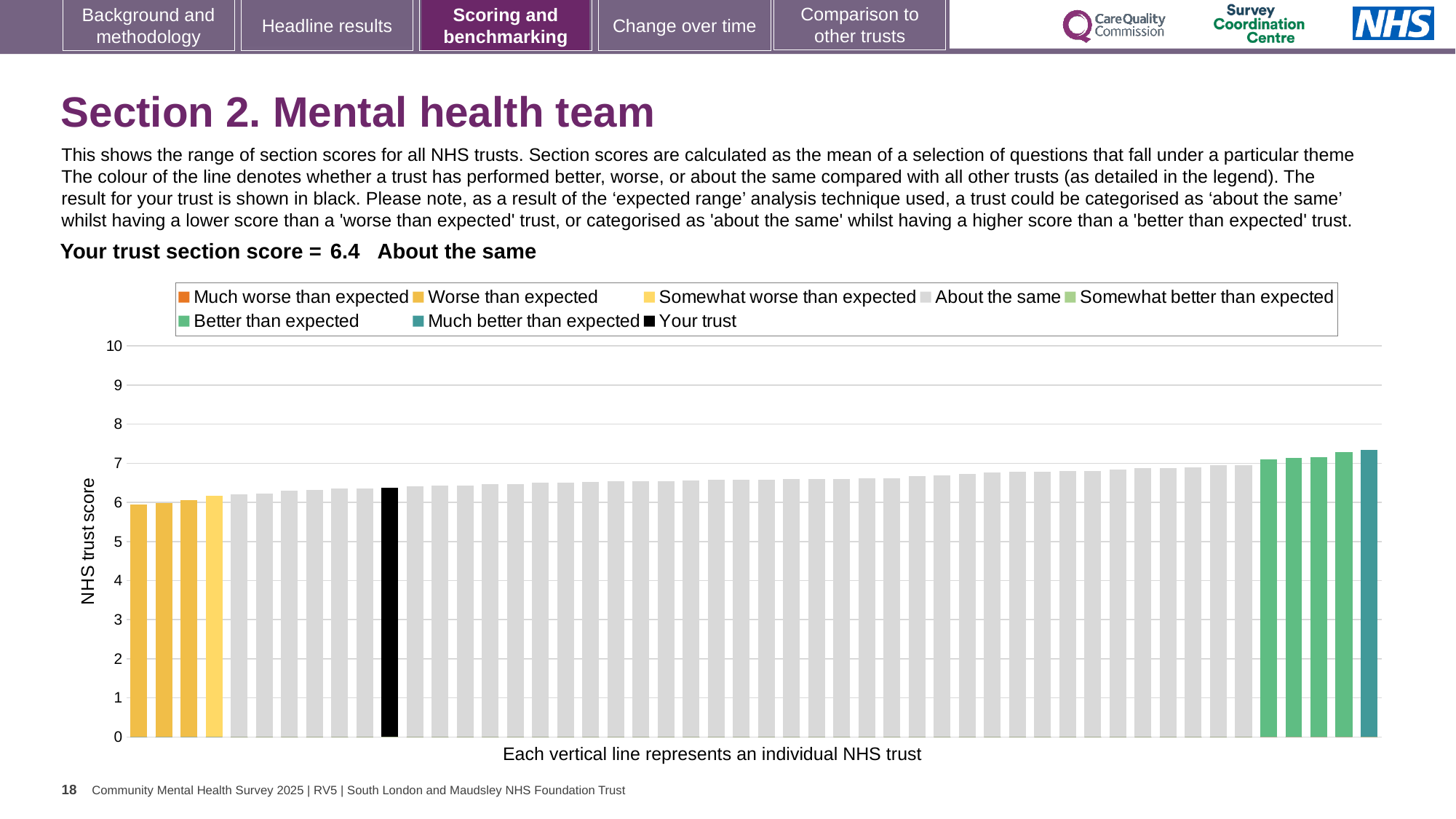
Which category is your trust placed in for this section? About the same Which legend category does the tallest bar belong to? Much better than expected What is the label on the y axis of the chart? NHS trust score Which legend category does the shortest bar belong to? Worse than expected Is the value of the shortest bar greater or less than 5? greater What colour is the bar representing your trust? black Do the bar values rise or fall from left to right along the x axis? rise What kind of chart is shown on the slide? bar chart How many entries does the chart legend list? 8 Is the value for your trust (the black bar) greater or less than 5? greater Is the value of the tallest bar greater or less than 7? greater What is the section score for your trust shown on the slide? 6.4